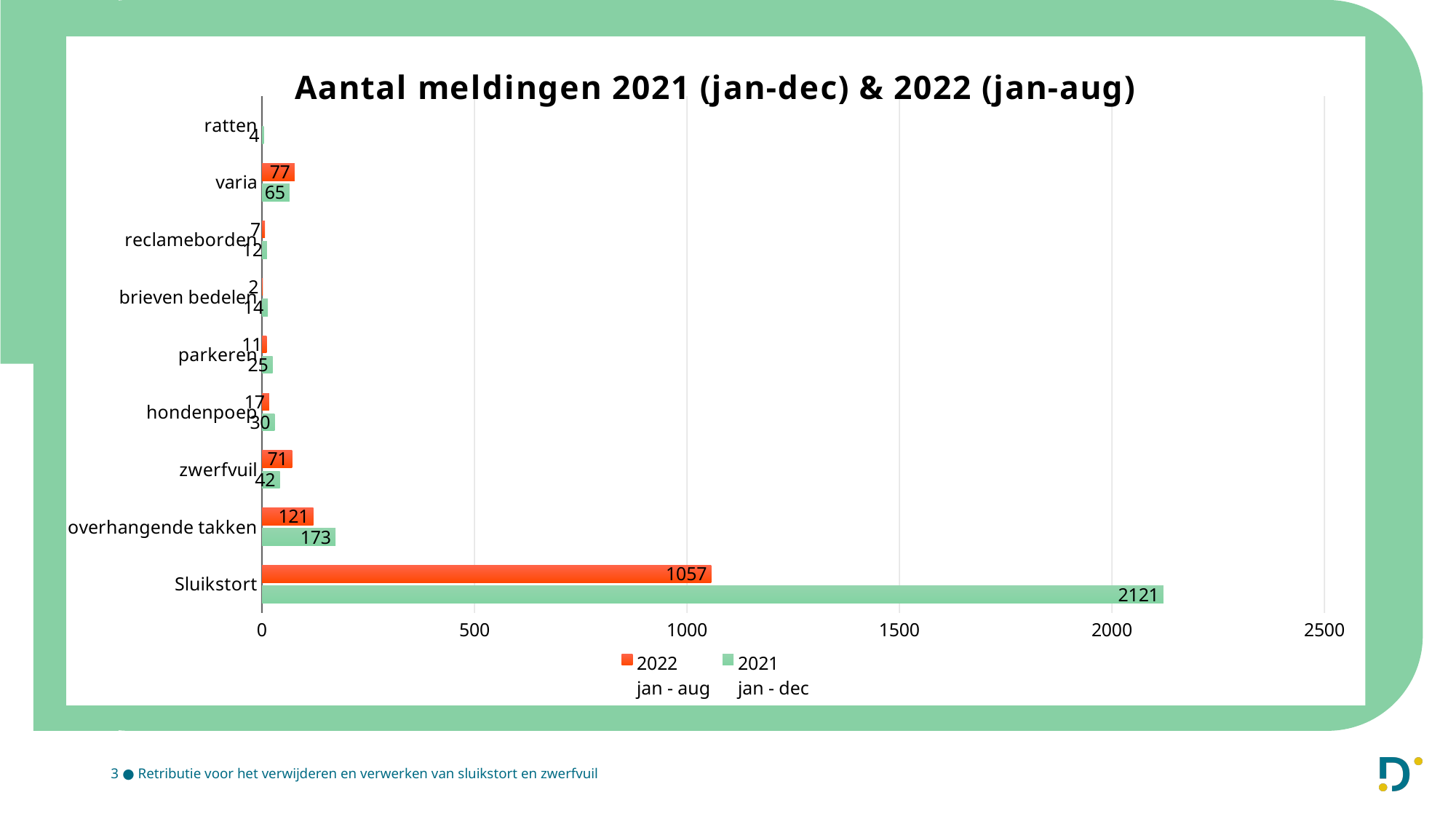
How many categories are shown on the vertical axis of the chart? 9 What is the 2021 (jan - dec) value for hondenpoep? 30 What is the difference between the 2021 (jan - dec) and 2022 (jan - aug) values for Sluikstort? 1064 For zwerfvuil, which is larger: the 2022 (jan - aug) value or the 2021 (jan - dec) value? 2022 (jan - aug) Which category has the lowest 2021 (jan - dec) value? ratten Which category has the highest 2022 (jan - aug) value? Sluikstort What is the title of the chart? Aantal meldingen 2021 (jan-dec) & 2022 (jan-aug) Is the 2022 (jan - aug) value for Sluikstort greater or less than 1000? greater How many series does the legend list? 2 What is the 2022 (jan - aug) value for overhangende takken? 121 What is the 2021 (jan - dec) value for Sluikstort? 2121 What type of chart is shown on the slide? bar chart